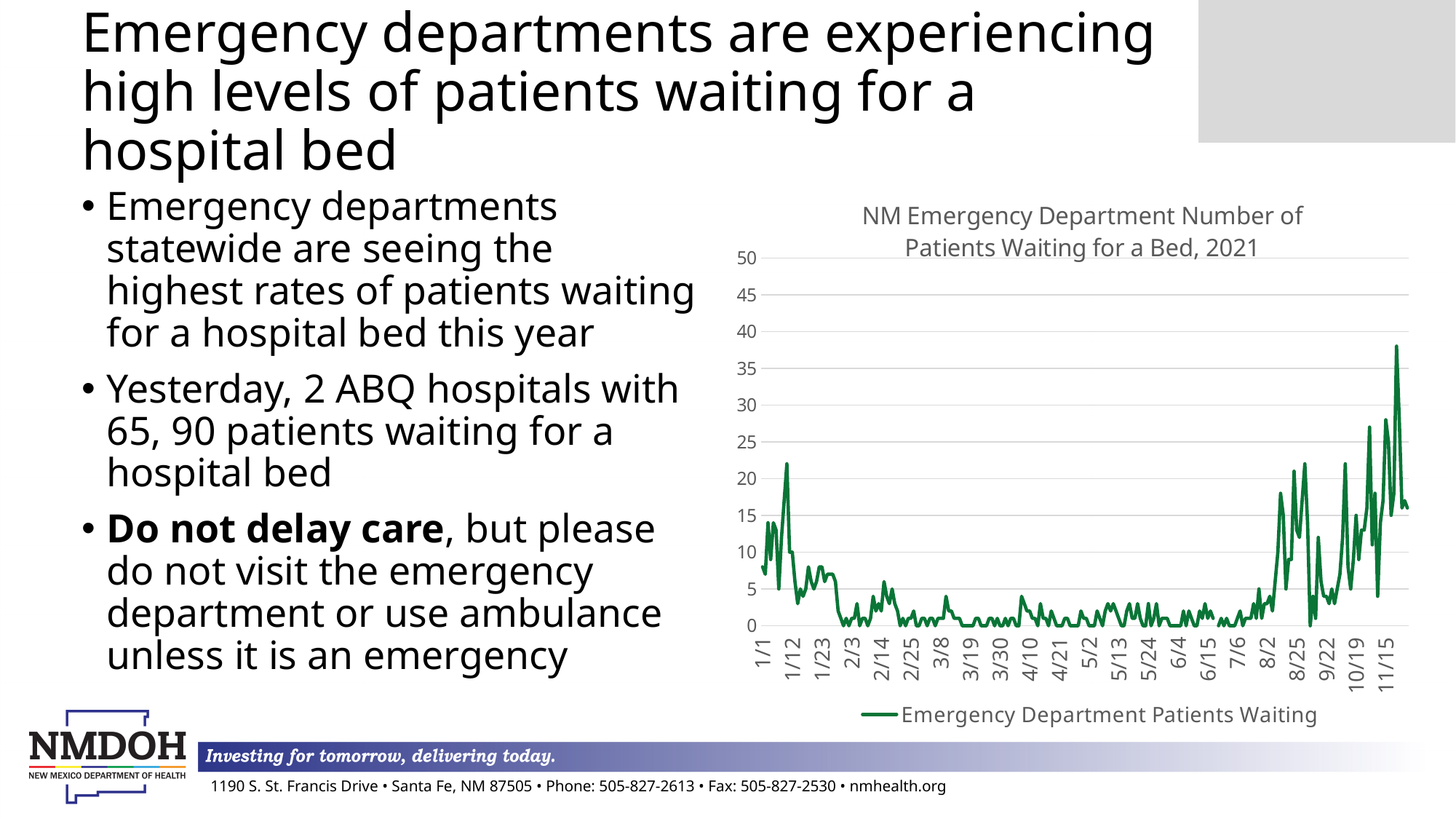
How many series does the chart legend list? 1 Does the highest value on the chart occur near the start or near the end of the year? near the end Is the peak value near 1/12 greater or less than 15? greater Is the highest value on the chart greater or less than 35? greater What is the legend entry for the plotted line? Emergency Department Patients Waiting Is the highest value on the chart greater or less than 40? less Do the values generally rise or fall between 1/12 and 2/3? fall What is the title of the chart? NM Emergency Department Number of Patients Waiting for a Bed, 2021 Do the values generally rise or fall between 8/2 and 11/15? rise What kind of chart is shown on the slide? line chart Which period has higher values: around 3/19 or around 10/19? around 10/19